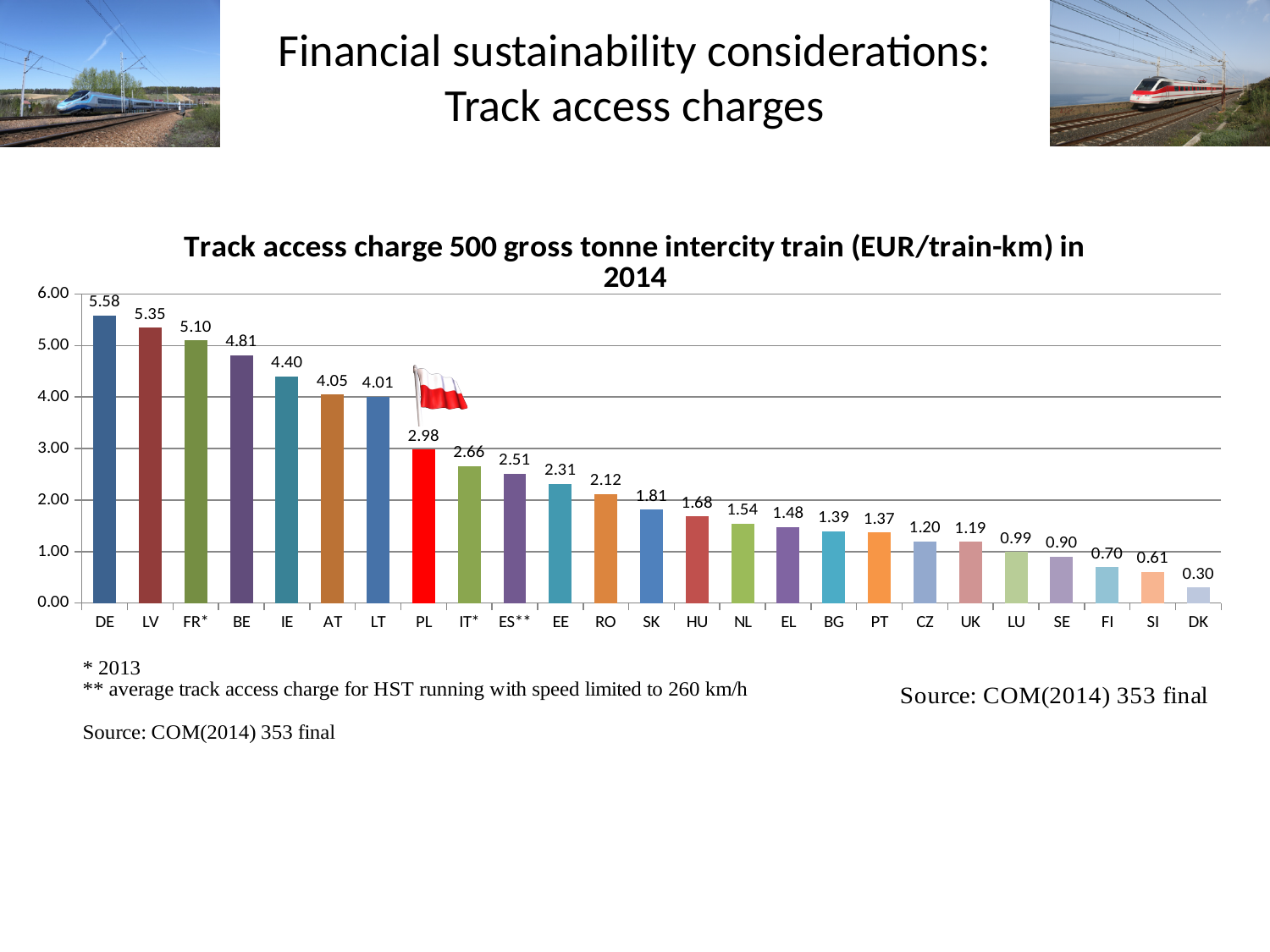
Is the value for BE greater or less than 4.00? greater Do the values rise or fall from left to right along the x axis? Fall What is the difference between the values for LV and LT? 1.34 What is the difference between the values for DE and PL? 2.60 Which has a higher track access charge, IE or EE? IE What kind of chart is shown on the slide? Bar chart What is the value shown for SK? 1.81 How many countries are shown on the chart? 25 What is the track access charge for DE? 5.58 What is the track access charge for PL? 2.98 Which country has the highest track access charge? DE Which country has the lowest track access charge? DK